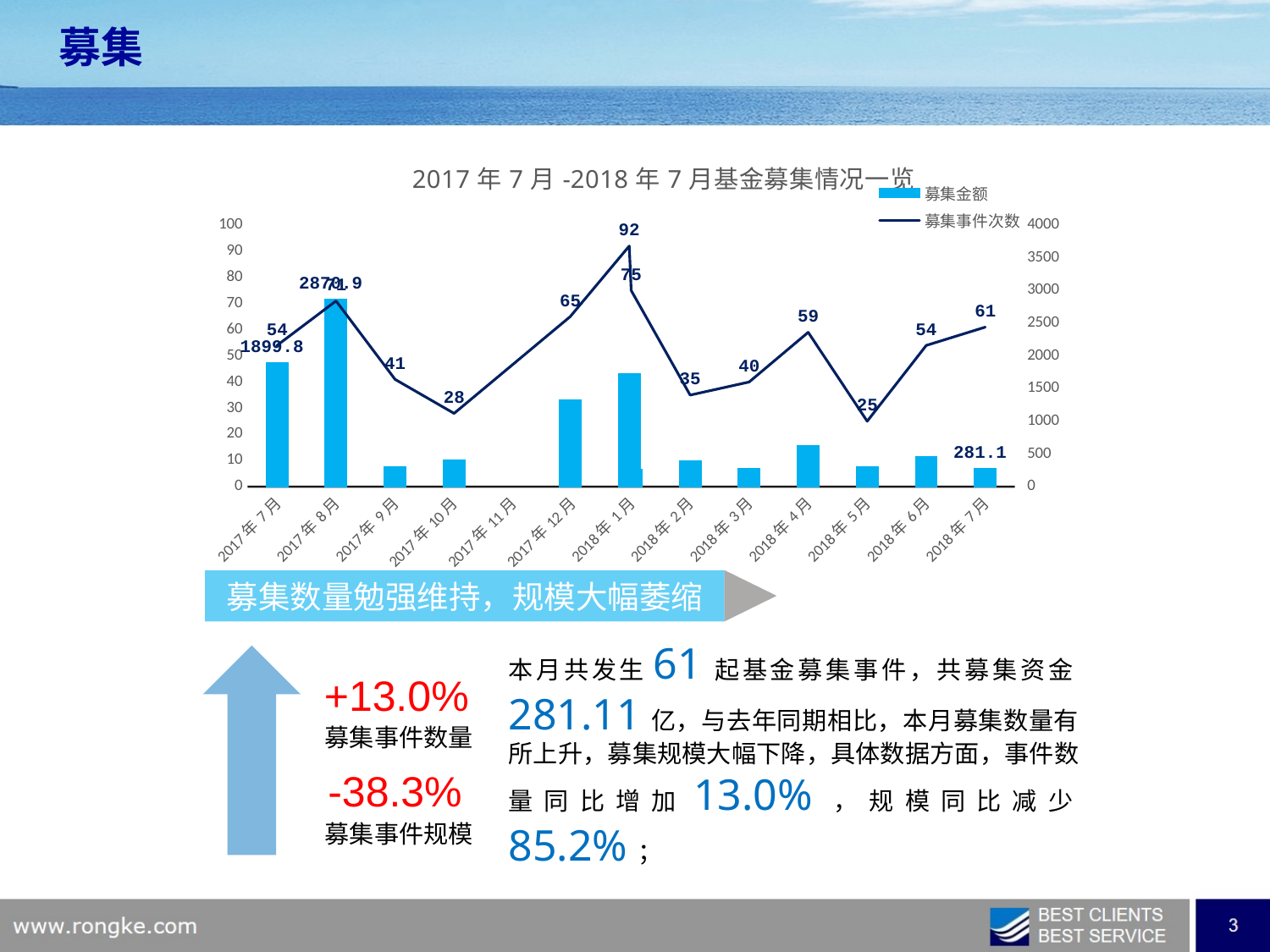
What is the 募集事件次数 value for 2017年7月? 54 What kind of chart is shown on the slide? Combined bar and line chart Which month has the highest 募集金额 bar? 2017年8月 Which month has the lowest 募集事件次数 value? 2018年5月 What is the 募集金额 value for 2018年7月? 281.1 What is the title of the chart? 2017年7月-2018年7月基金募集情况一览 How many series does the chart legend list? 2 What is the difference in 募集事件次数 between 2018年4月 (59) and 2018年5月 (25)? 34 Which has a higher 募集事件次数 value, 2018年3月 or 2018年4月? 2018年4月 How many month categories are shown on the x axis of the chart? 13 What is the 募集事件次数 value for 2018年5月? 25 Is the 募集金额 bar for 2017年9月 greater or less than 500? less